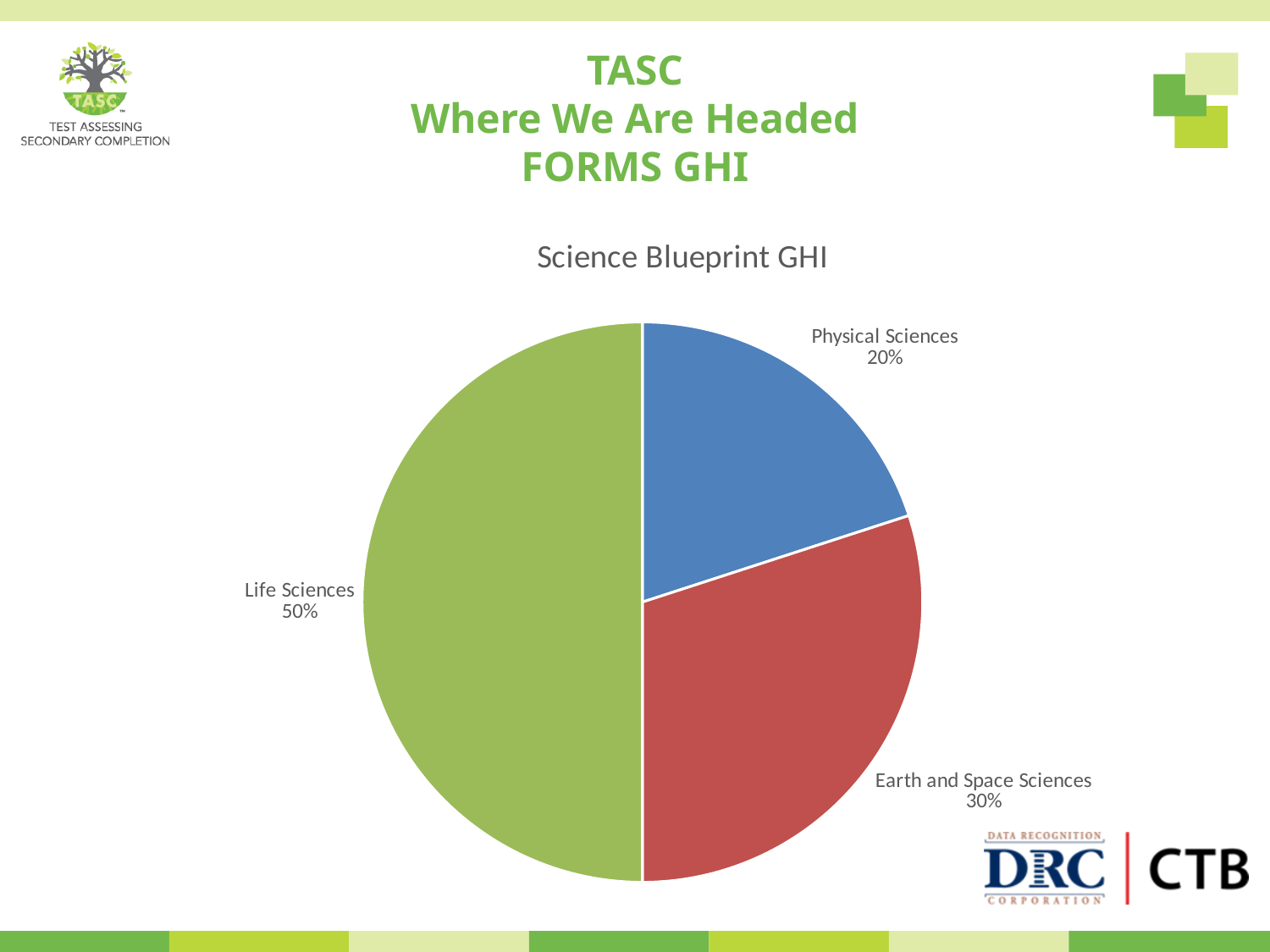
What colour is the Life Sciences slice? green What is the difference between the Life Sciences share and the Earth and Space Sciences share? 20% What is the difference between the Earth and Space Sciences share and the Physical Sciences share? 10% What percentage of the pie is Physical Sciences? 20% Which category has the smallest share of the pie? Physical Sciences Which category has the largest share of the pie? Life Sciences How many slices does the pie chart have? 3 What percentage of the pie is Life Sciences? 50% Which is larger, the share for Earth and Space Sciences or the share for Physical Sciences? Earth and Space Sciences What type of chart is shown on the slide? pie chart What is the title of the chart? Science Blueprint GHI What percentage of the pie is Earth and Space Sciences? 30%